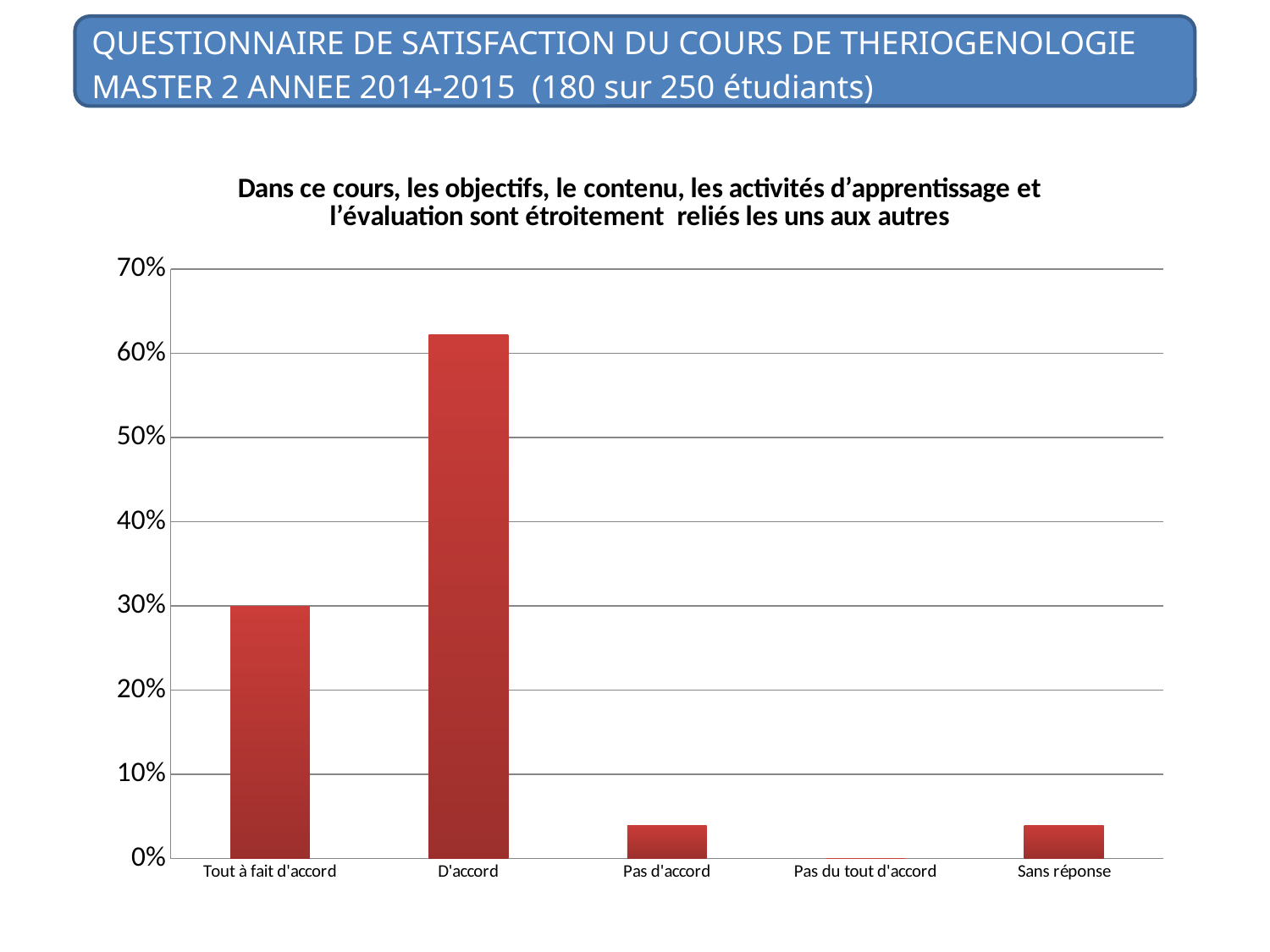
Which category has the lowest value in the chart? Pas du tout d'accord Is the value for Pas d'accord greater or less than 10%? less Is the value for Tout à fait d'accord greater or less than 40%? less Which is larger, the value for Tout à fait d'accord or the value for Pas d'accord? Tout à fait d'accord Is the value for Sans réponse greater or less than 10%? less Which is larger, the value for Tout à fait d'accord or the value for D'accord? D'accord Which category has the highest value in the chart? D'accord What kind of chart is shown on the slide? bar chart What is the title of the chart? Dans ce cours, les objectifs, le contenu, les activités d'apprentissage et l'évaluation sont étroitement reliés les uns aux autres How many categories are shown on the x axis of the chart? 5